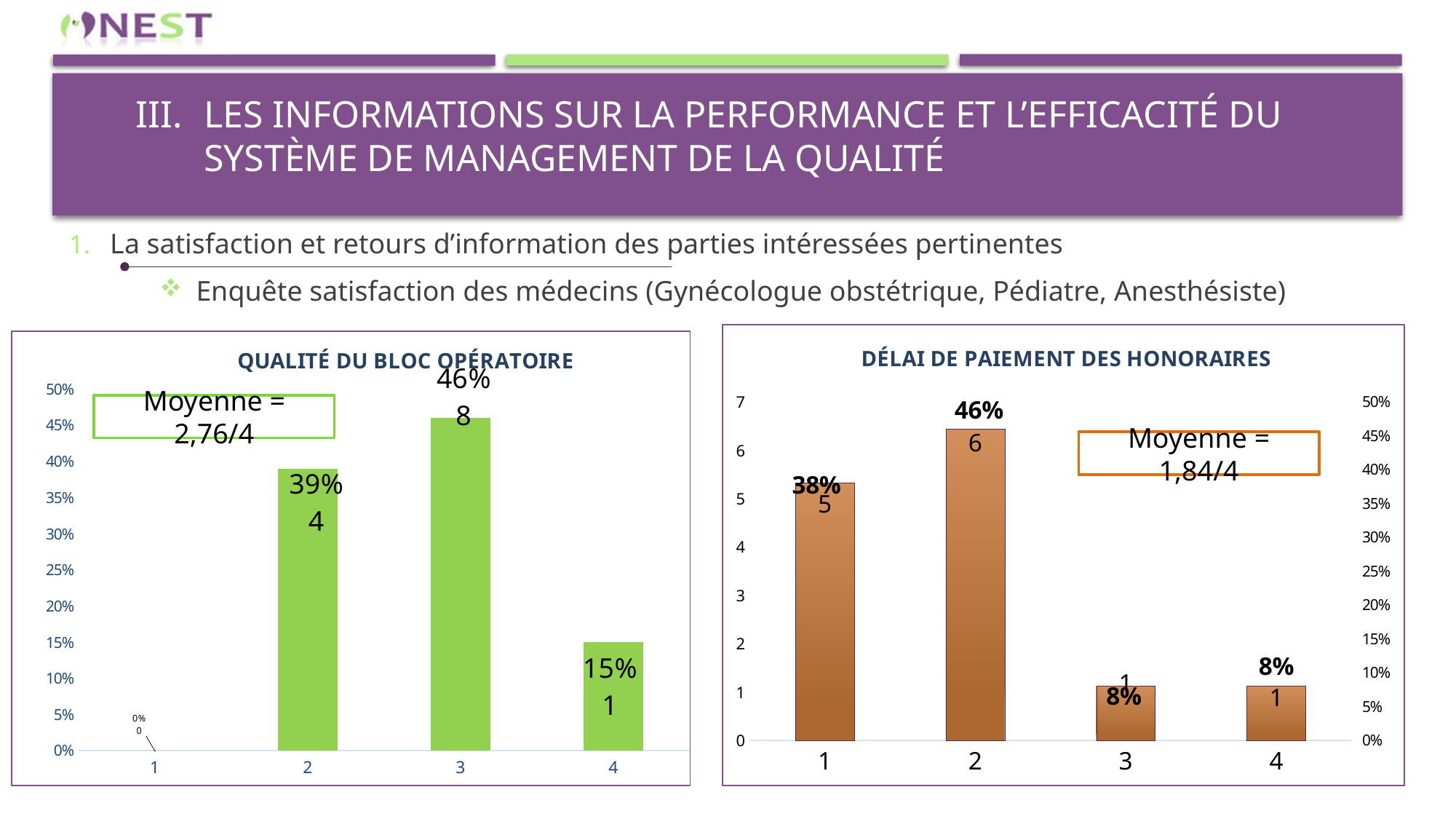
In the 'QUALITÉ DU BLOC OPÉRATOIRE' chart, what average (Moyenne) is shown in the box? 2,76/4 In the 'QUALITÉ DU BLOC OPÉRATOIRE' chart, which category has the highest value? 3 In the 'DÉLAI DE PAIEMENT DES HONORAIRES' chart, which is larger, the value for category 1 or category 3? category 1 In the 'DÉLAI DE PAIEMENT DES HONORAIRES' chart, which category has the highest value? 2 What type of chart is 'DÉLAI DE PAIEMENT DES HONORAIRES'? bar chart In the 'DÉLAI DE PAIEMENT DES HONORAIRES' chart, what percentage is shown for category 1? 38% In the 'QUALITÉ DU BLOC OPÉRATOIRE' chart, what is the difference in percentage points between category 3 and category 4? 31 In the 'DÉLAI DE PAIEMENT DES HONORAIRES' chart, what count is shown for category 2? 6 In the 'QUALITÉ DU BLOC OPÉRATOIRE' chart, what percentage is shown for category 3? 46% In the 'QUALITÉ DU BLOC OPÉRATOIRE' chart, what count is shown for category 2? 4 In the 'DÉLAI DE PAIEMENT DES HONORAIRES' chart, how many categories are shown on the x axis? 4 In the 'QUALITÉ DU BLOC OPÉRATOIRE' chart, which category has the lowest value? 1